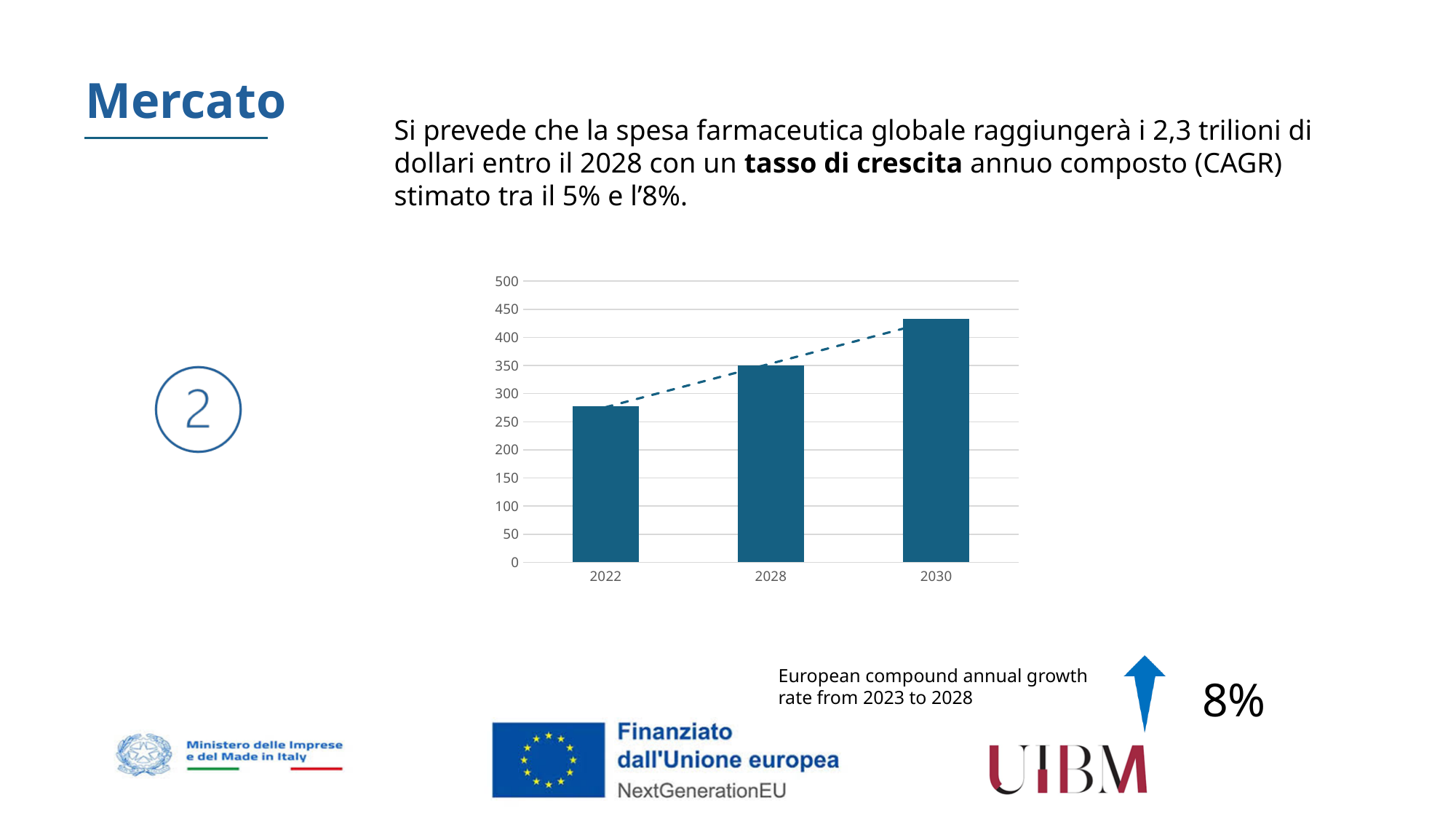
How many bars (years) are plotted in the chart? 3 Which year has the highest bar in the chart? 2030 Is the value for 2022 greater or less than 250? greater Is the value for 2030 greater or less than 450? less Do the values rise or fall from 2022 to 2030 along the x axis? rise Which is larger, the value for 2028 or the value for 2030? 2030 Is the value for 2030 greater or less than 400? greater What kind of chart is shown on the slide? bar chart Which year has the lowest bar in the chart? 2022 What is the highest value shown on the vertical axis of the chart? 500